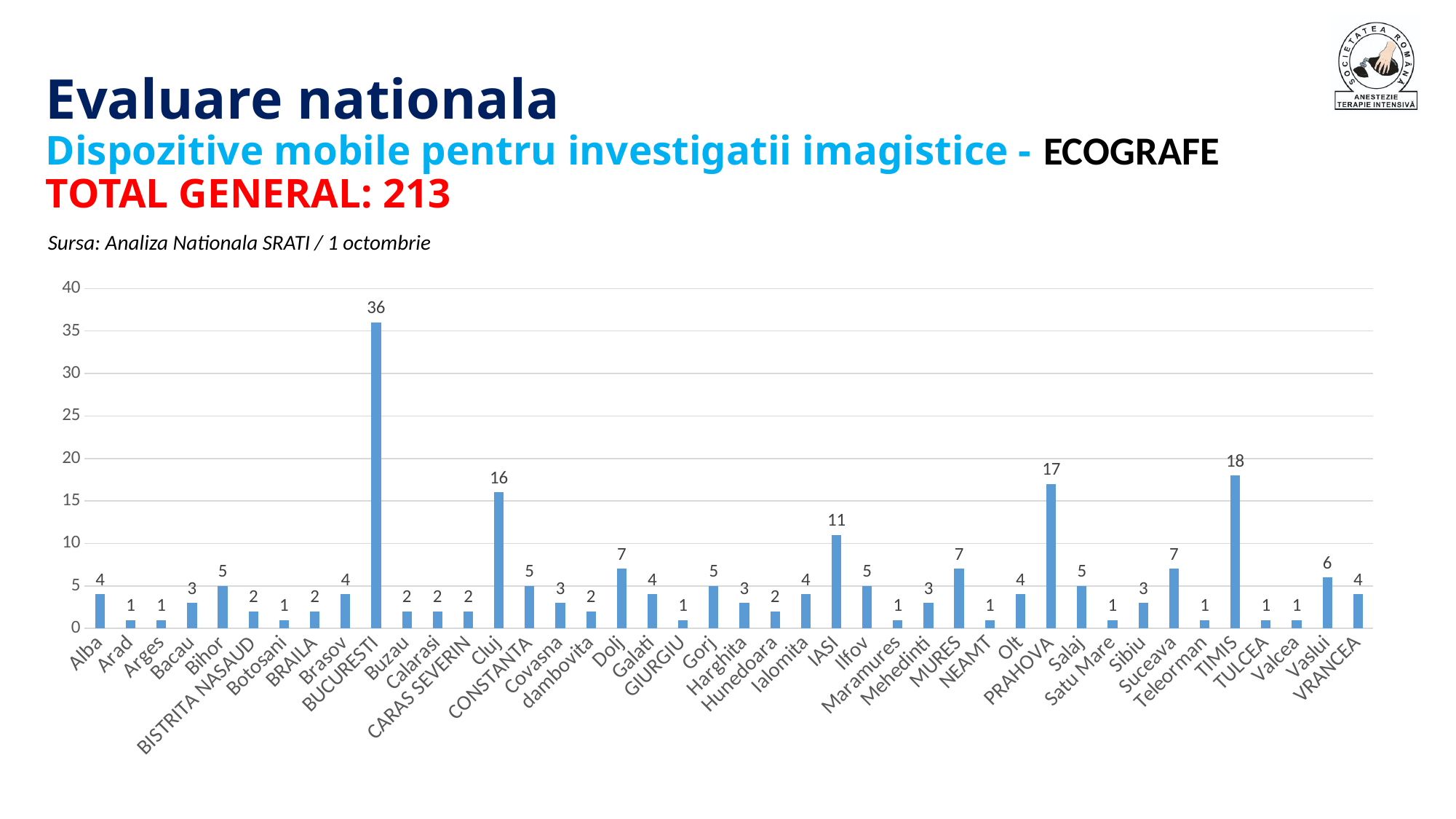
Which is larger, the value for TIMIS or the value for PRAHOVA? TIMIS What is the value for IASI? 11 Which is larger, the value for Cluj or the value for IASI? Cluj What is the difference between the values for Cluj and Dolj? 9 What is the value for PRAHOVA? 17 What is the value for BUCURESTI? 36 What kind of chart is shown on the slide? bar chart Which category has the highest value? BUCURESTI What total is stated in red on the slide? 213 How many categories are shown on the x axis? 42 What is the value for Vaslui? 6 What is the difference between the values for BUCURESTI and TIMIS? 18